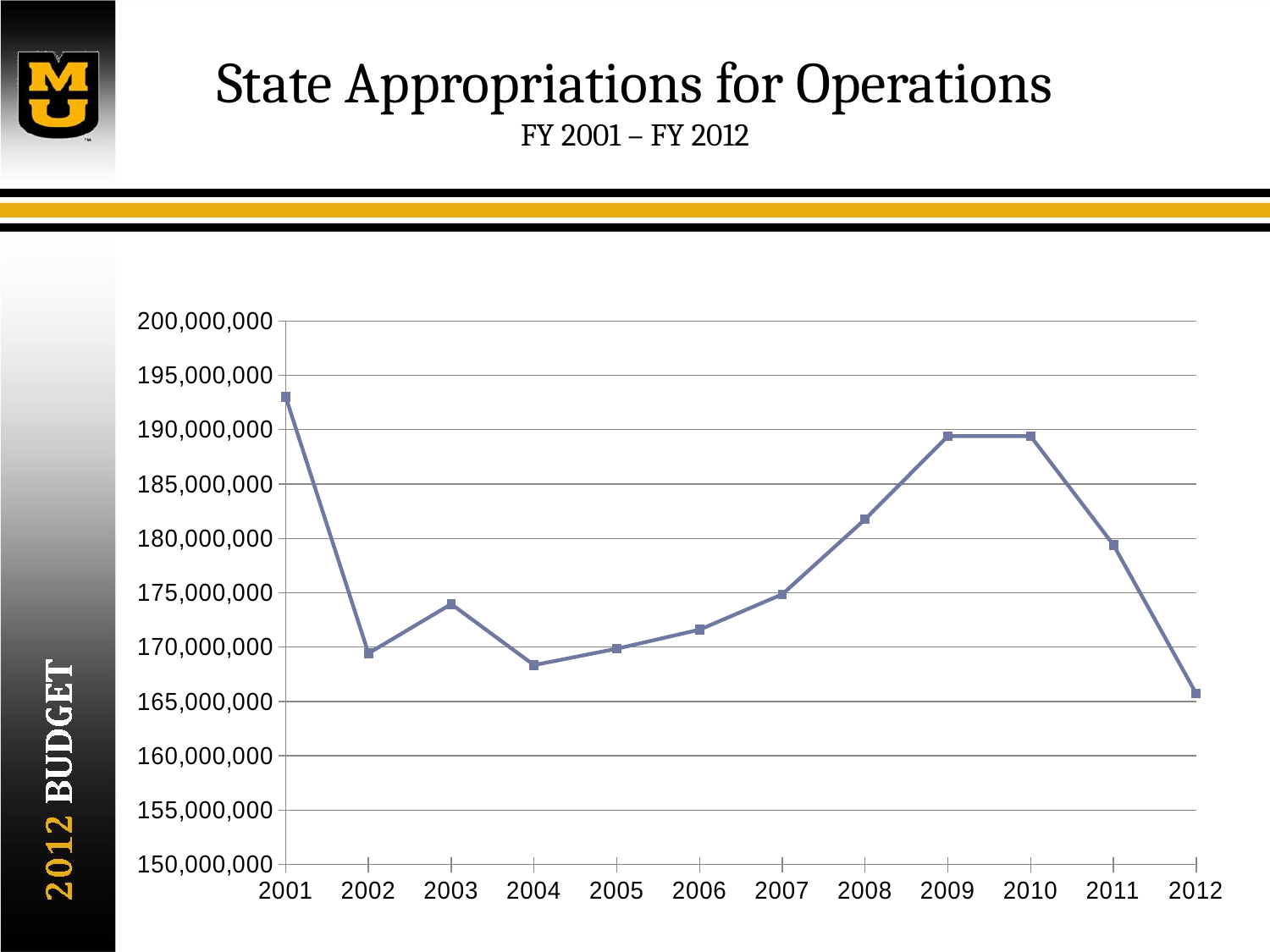
Do the values rise or fall from 2004 to 2009? Rise Is the value for 2008 greater or less than 180,000,000? greater Is the value for 2004 greater or less than 170,000,000? less Which year has the lowest state appropriation for operations? 2012 Which year has a larger value, 2001 or 2009? 2001 What is the title of the chart on the slide? State Appropriations for Operations FY 2001 – FY 2012 Which year has the highest state appropriation for operations? 2001 Is the value for 2012 greater or less than 170,000,000? less What kind of chart is shown on the slide? Line chart Which year has a larger value, 2003 or 2004? 2003 How many fiscal years are plotted on the x axis? 12